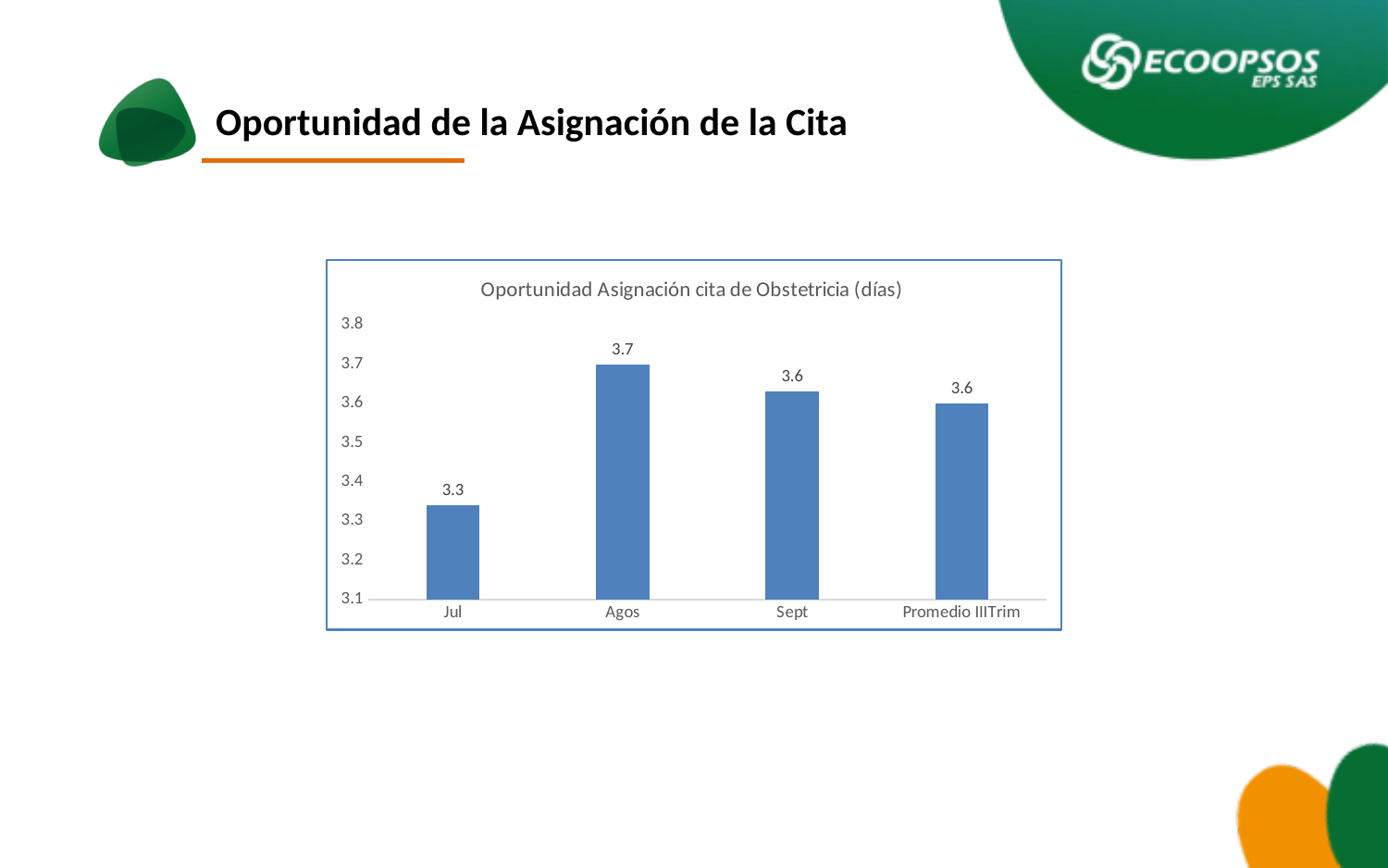
What is the value for Promedio IIITrim? 3.6 What is the value for Agos? 3.7 Which category has the lowest value? Jul What is the value for Sept? 3.6 What is the difference between the values for Agos and Jul? 0.4 How many categories are shown on the x axis? 4 What kind of chart is shown? bar chart Which is larger, the value for Jul or the value for Sept? Sept Is the value for Jul greater or less than 3.5? less What is the value for Jul? 3.3 What is the title of the chart? Oportunidad Asignación cita de Obstetricia (días) Which category has the highest value? Agos